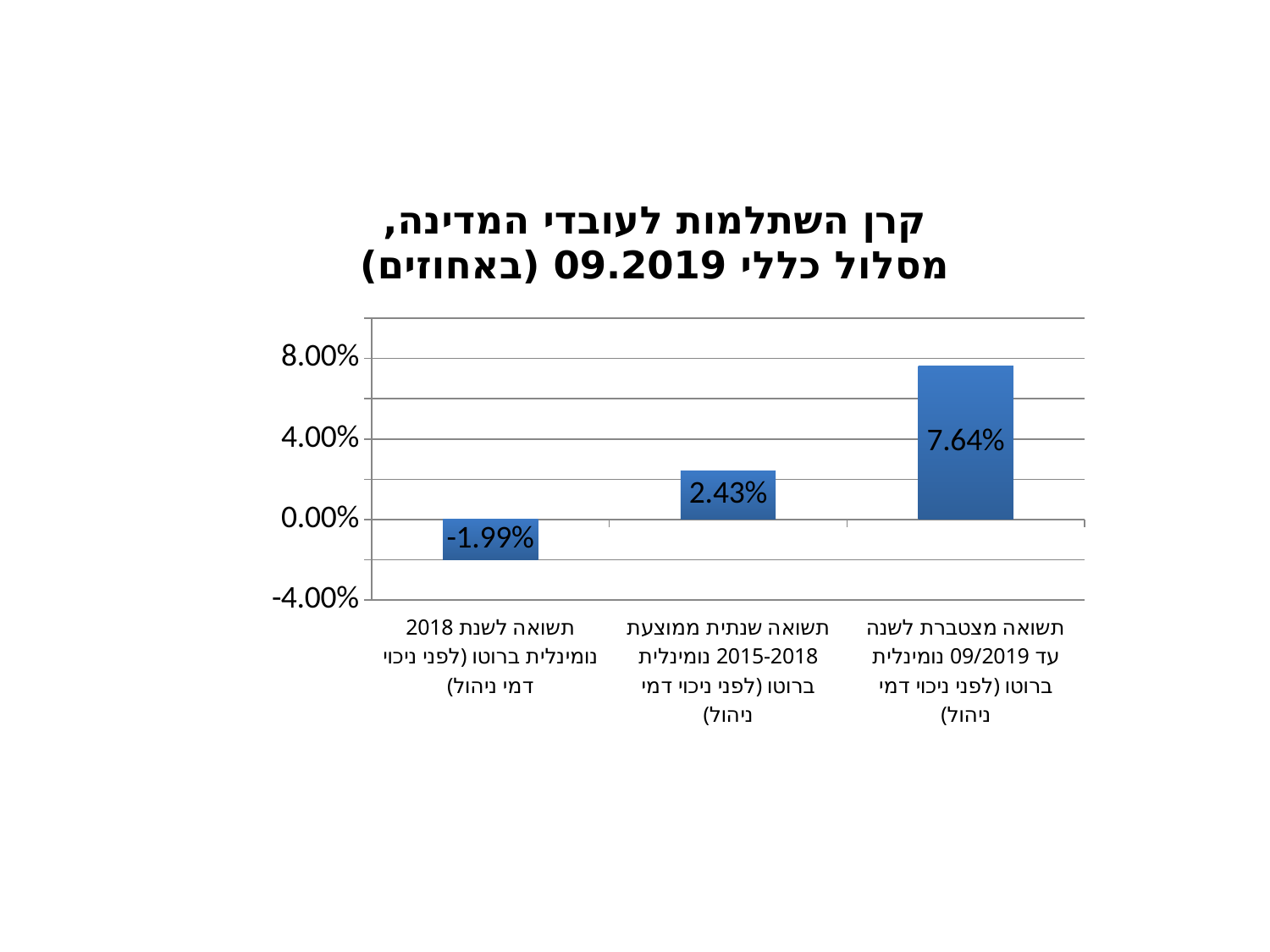
Which category has the highest value? תשואה מצטברת לשנה עד 09/2019 נומינלית ברוטו (לפני ניכוי דמי ניהול) Do the bar values rise or fall from left to right along the x axis? rise Which is larger: the value for 'תשואה שנתית ממוצעת 2015-2018' or the value for 'תשואה לשנת 2018'? תשואה שנתית ממוצעת 2015-2018 What is the difference between the value for 'תשואה מצטברת לשנה עד 09/2019' and the value for 'תשואה שנתית ממוצעת 2015-2018'? 5.21% What is the title of the chart? קרן השתלמות לעובדי המדינה, מסלול כללי 09.2019 (באחוזים) What is the value of the bar for 'תשואה מצטברת לשנה עד 09/2019 נומינלית ברוטו (לפני ניכוי דמי ניהול)'? 7.64% What is the value of the bar for 'תשואה שנתית ממוצעת 2015-2018 נומינלית ברוטו (לפני ניכוי דמי ניהול)'? 2.43% How many bars (categories) does the chart show? 3 What type of chart is shown on the slide? bar chart What is the value of the bar for 'תשואה לשנת 2018 נומינלית ברוטו (לפני ניכוי דמי ניהול)'? -1.99% Which category has the lowest value? תשואה לשנת 2018 נומינלית ברוטו (לפני ניכוי דמי ניהול) Is the value for 'תשואה מצטברת לשנה עד 09/2019' greater or less than 4.00%? greater